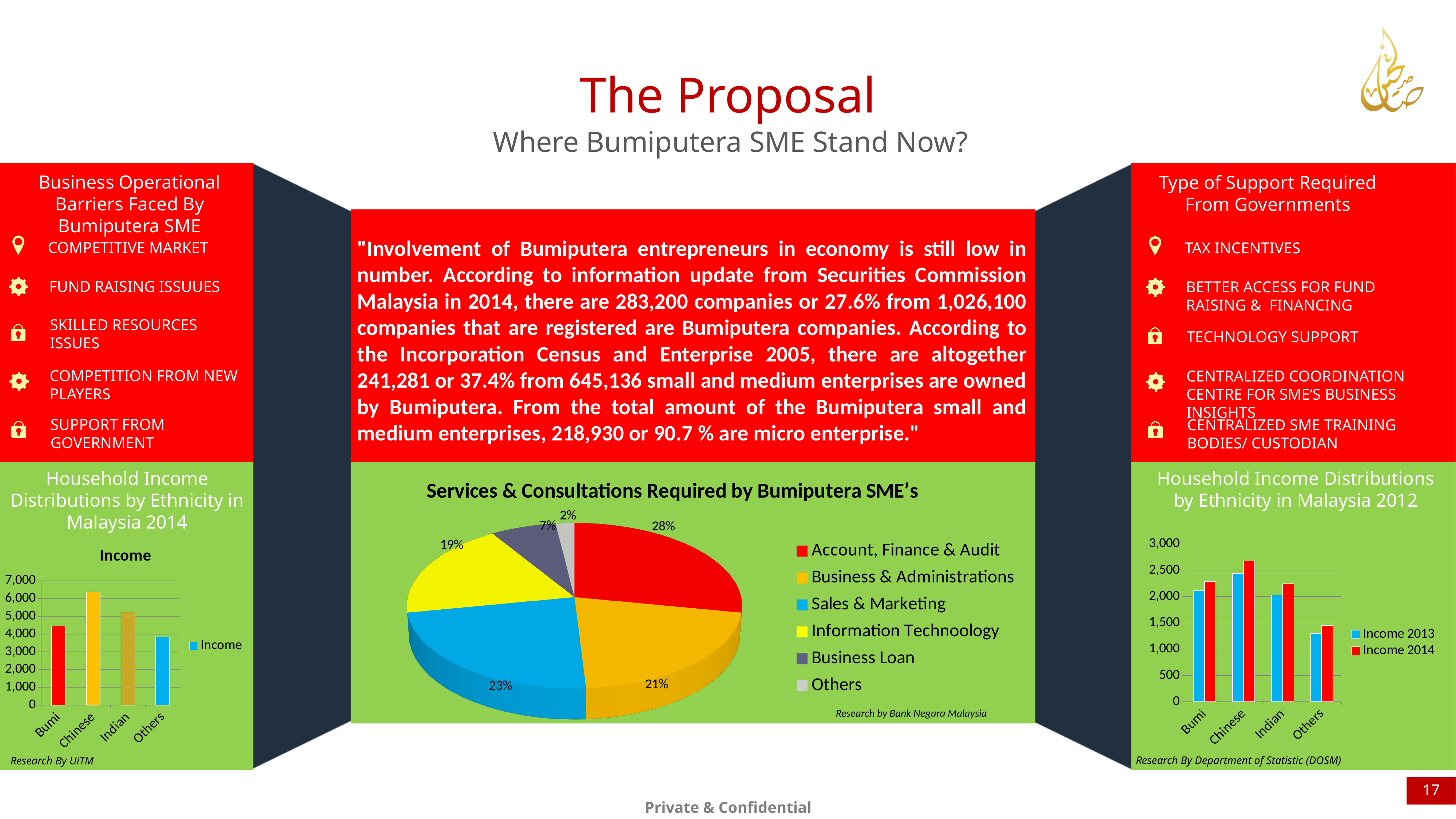
In the pie chart titled 'Services & Consultations Required by Bumiputera SME's', which category has the smallest share? Others In the bar chart on the left titled 'Income', which ethnicity has the highest income? Chinese In the pie chart titled 'Services & Consultations Required by Bumiputera SME's', what percentage is shown for Account, Finance & Audit? 28% In the bar chart on the right (Household Income Distributions by Ethnicity in Malaysia 2012), how many series does the legend list? 2 In the pie chart titled 'Services & Consultations Required by Bumiputera SME's', which category has the largest share? Account, Finance & Audit In the bar chart on the left titled 'Income', which ethnicity has the lowest income? Others What type of chart is the middle chart titled 'Services & Consultations Required by Bumiputera SME's'? Pie chart In the pie chart titled 'Services & Consultations Required by Bumiputera SME's', how many categories does the legend list? 6 In the bar chart on the left titled 'Income', is the value for Bumi greater or less than 4,000? greater In the pie chart titled 'Services & Consultations Required by Bumiputera SME's', what percentage is shown for Information Technoology? 19% In the pie chart titled 'Services & Consultations Required by Bumiputera SME's', what is the difference in percentage points between Sales & Marketing and Business Loan? 16